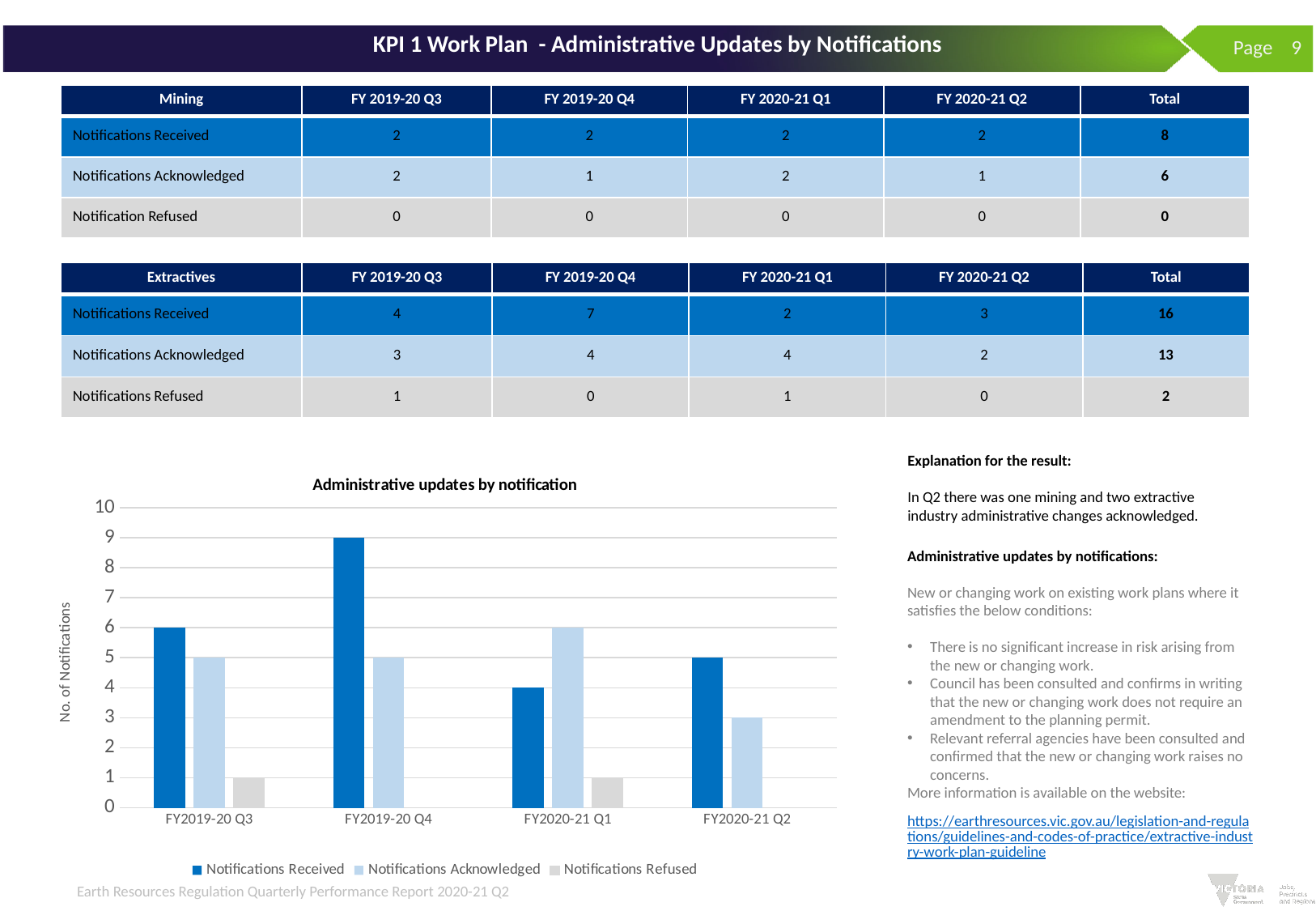
What is the value of Notifications Acknowledged for FY2020-21 Q1? 6 Is the value of Notifications Received for FY2020-21 Q2 greater or less than 4? greater In FY2020-21 Q1, which is larger: Notifications Received or Notifications Acknowledged? Notifications Acknowledged What is the value of Notifications Received for FY2019-20 Q4? 9 What is the title of the chart? Administrative updates by notification What type of chart is shown on the slide? bar chart What is the difference between Notifications Received and Notifications Acknowledged in FY2019-20 Q4? 4 In which quarter is Notifications Received highest? FY2019-20 Q4 In which quarter is Notifications Received lowest? FY2020-21 Q1 How many quarters are shown on the x axis of the chart? 4 How many series does the chart legend list? 3 What is the value of Notifications Received for FY2019-20 Q3? 6